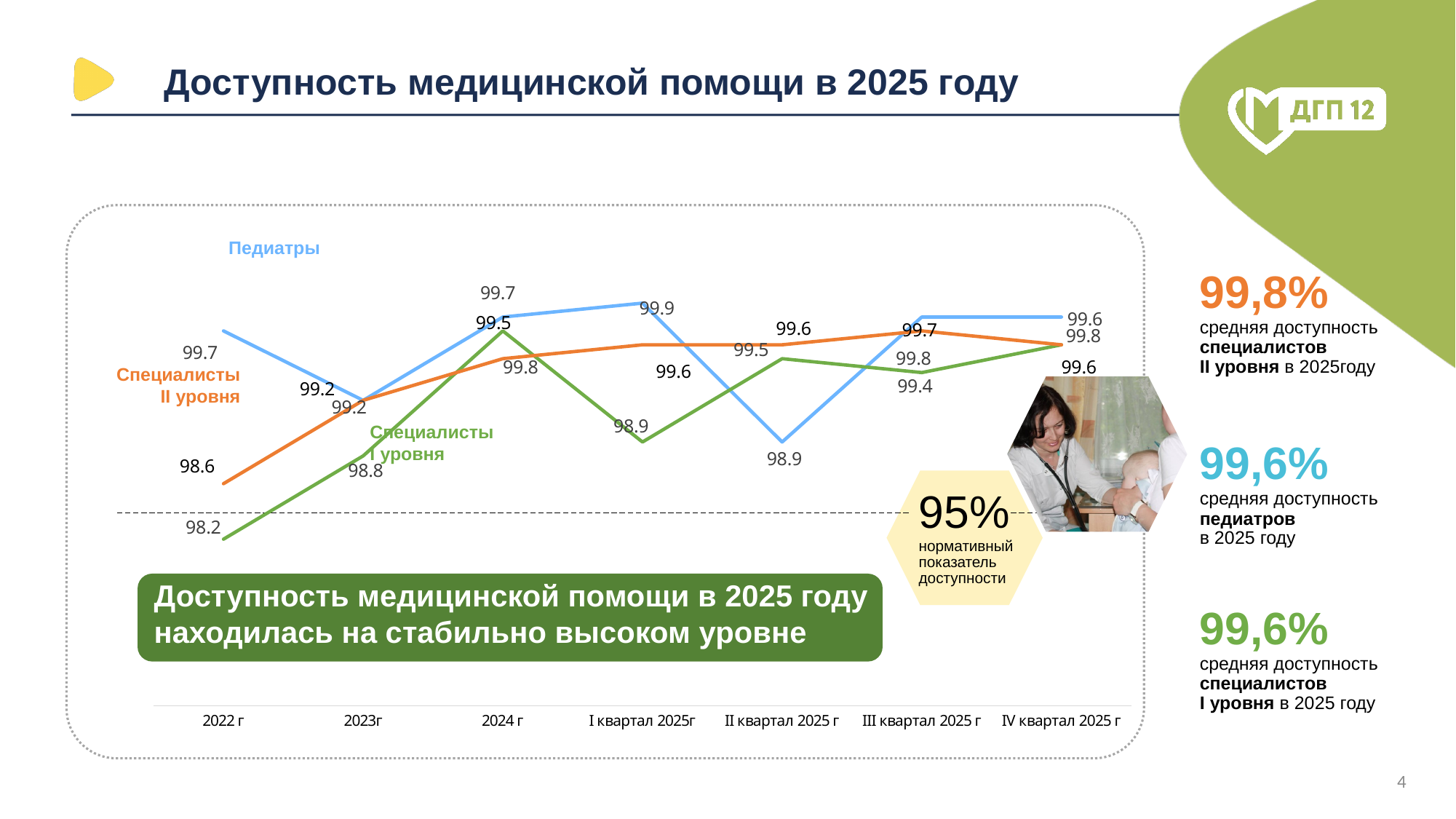
What is the difference between Педиатры and Специалисты I уровня in 2022 г? 1.5 What is the value for Педиатры in I квартал 2025г? 99.9 In which category does the Педиатры series reach its lowest value? II квартал 2025 г What is the value for Специалисты II уровня in 2022 г? 98.6 How many series does the chart show? 3 Which is larger in 2022 г: Педиатры or Специалисты II уровня? Педиатры What kind of chart is shown on the slide? line chart In which category does the Специалисты I уровня series have its lowest value? 2022 г What is the value for Педиатры in 2022 г? 99.7 What is the value for Специалисты I уровня in 2022 г? 98.2 How many categories are on the x axis of the chart? 7 What normative accessibility indicator is marked by the dashed line on the chart? 95%